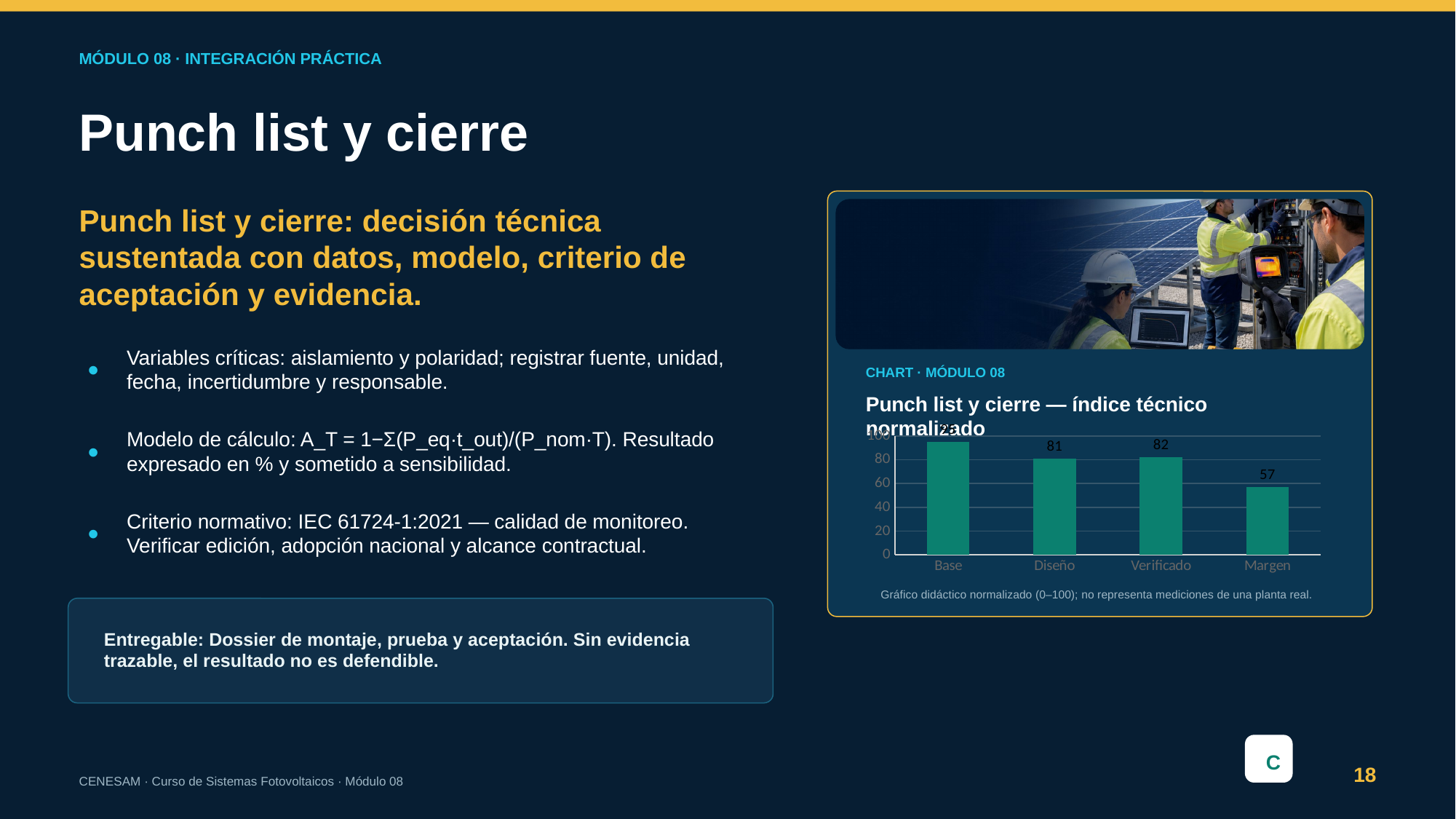
Which category has the highest value? Base What is the difference between the values for Diseño and Margen? 24 Is the value for Margen greater or less than 60? less What is the value for Margen? 57 How many categories are shown on the x axis? 4 Which category has the lowest value? Margen What kind of chart is shown on the slide? bar chart What is the value for Diseño? 81 What is the value for Verificado? 82 Is the value for Base greater or less than 80? greater Which is larger, the value for Diseño or the value for Margen? Diseño What is the difference between the values for Verificado and Margen? 25